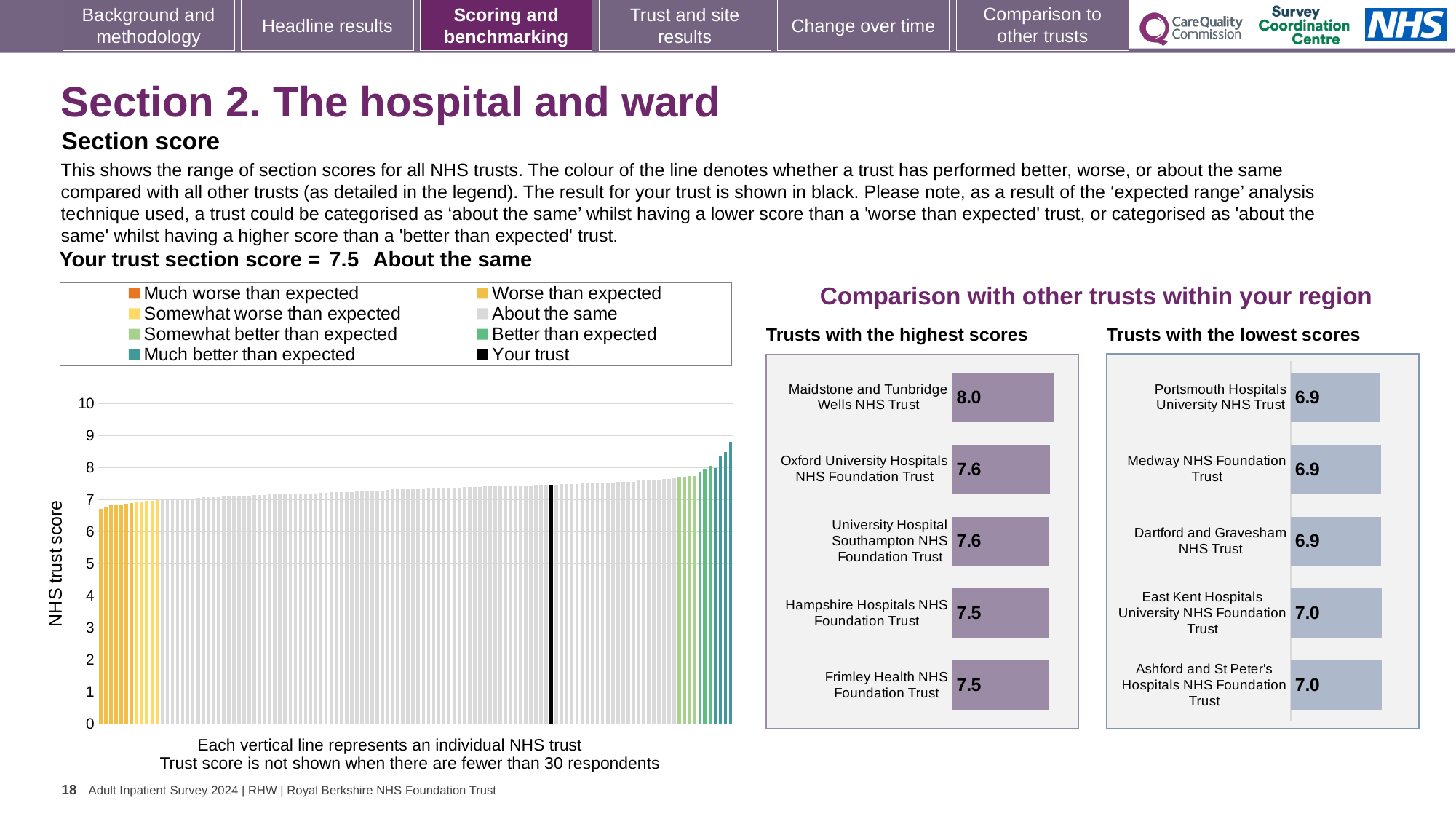
In the 'Trusts with the highest scores' chart, which trust has the highest score? Maidstone and Tunbridge Wells NHS Trust In the 'Trusts with the highest scores' chart, what is the score for Maidstone and Tunbridge Wells NHS Trust? 8.0 How many trusts are shown in the 'Trusts with the lowest scores' chart? 5 In the 'Trusts with the highest scores' chart, which has the larger score: Oxford University Hospitals NHS Foundation Trust or Hampshire Hospitals NHS Foundation Trust? Oxford University Hospitals NHS Foundation Trust In the left-hand NHS trust score chart, what colour is the bar for your trust? black What kind of chart is the large chart on the left showing NHS trust scores? bar chart How many entries does the legend of the left-hand NHS trust score chart list? 8 In the 'Trusts with the highest scores' chart, what is the difference between the scores of Maidstone and Tunbridge Wells NHS Trust and Frimley Health NHS Foundation Trust? 0.5 In the 'Trusts with the lowest scores' chart, what is the score for East Kent Hospitals University NHS Foundation Trust? 7.0 How many trusts are shown in the 'Trusts with the highest scores' chart? 5 In the left-hand NHS trust score chart, is the value of the tallest bar greater or less than 8? greater In the 'Trusts with the lowest scores' chart, what is the score for Dartford and Gravesham NHS Trust? 6.9